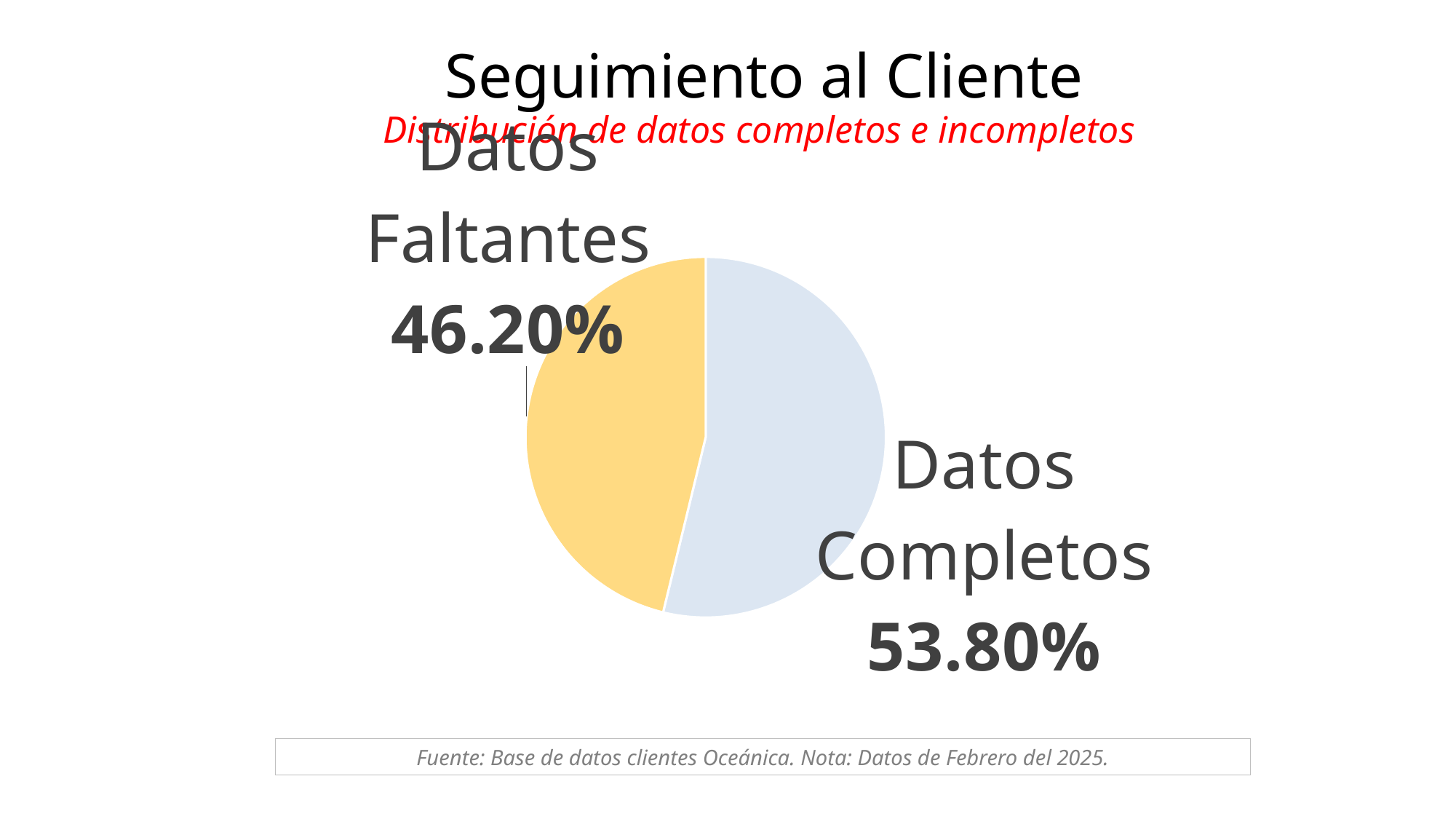
What kind of chart is shown on the slide? pie chart How many slices does the pie chart have? 2 Which slice of the pie is the smallest? Datos Faltantes What is the difference in percentage points between Datos Completos and Datos Faltantes? 7.60% What colour is the Datos Faltantes slice? yellow What is the subtitle of the chart shown in red? Distribución de datos completos e incompletos Which slice of the pie is the largest? Datos Completos What percentage is shown for Datos Faltantes? 46.20% Which is larger, Datos Completos or Datos Faltantes? Datos Completos What percentage is shown for Datos Completos? 53.80%